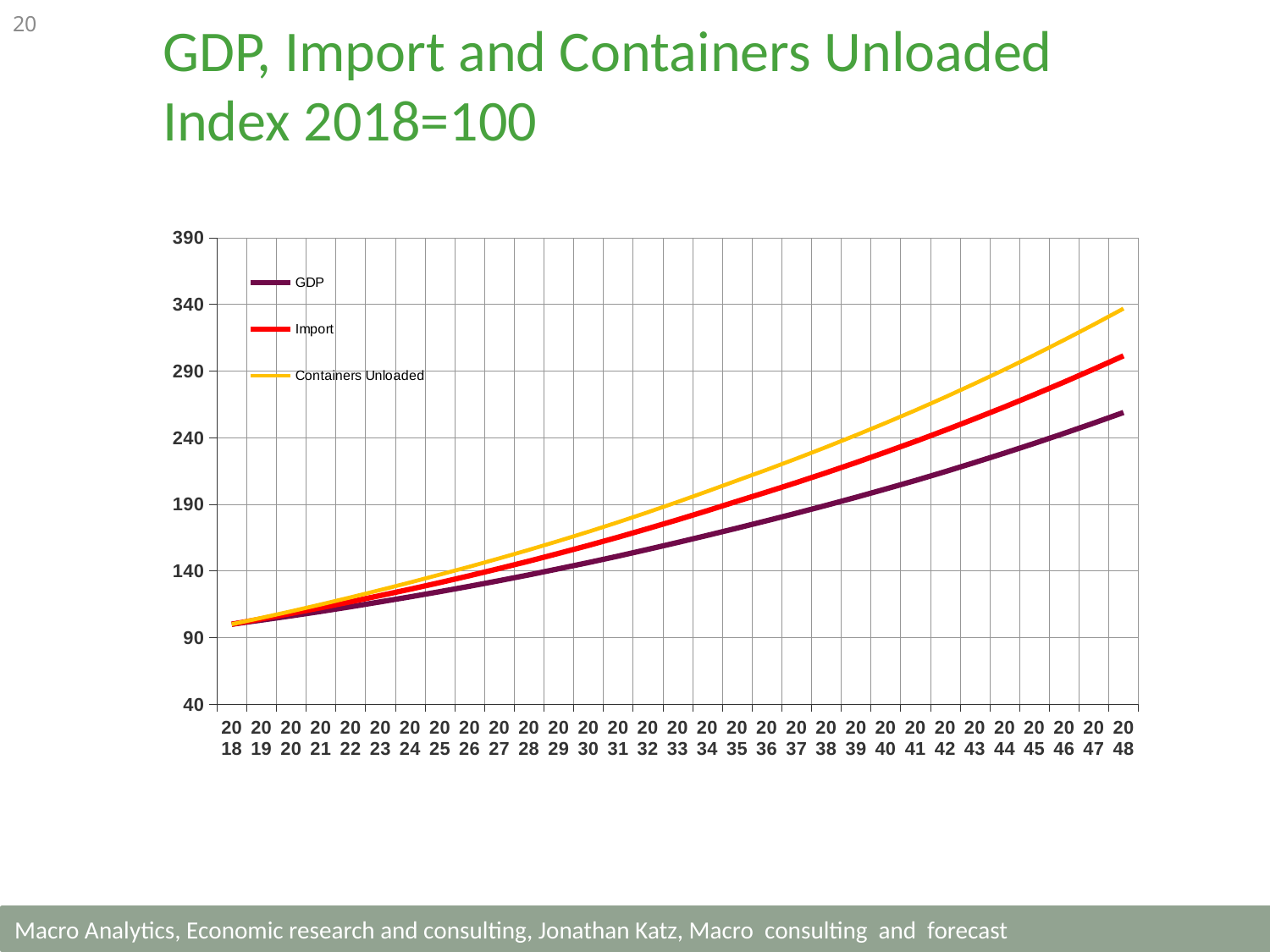
In 2048, which is larger: the Import value or the GDP value? Import What colour is the Import line in the chart? Red Is the value for Import in 2048 greater or less than 290? greater Which series has the lowest value in 2048? GDP Do the values of the GDP series rise or fall from 2018 to 2048? Rise How many series does the legend list? 3 What kind of chart is shown on the slide? Line chart What is the title of the chart on the slide? GDP, Import and Containers Unloaded Index 2018=100 Is the value for Containers Unloaded in 2030 greater or less than 190? less Is the value for GDP in 2048 greater or less than 240? greater Which series has the highest value in 2048? Containers Unloaded How many years are plotted along the x axis? 31